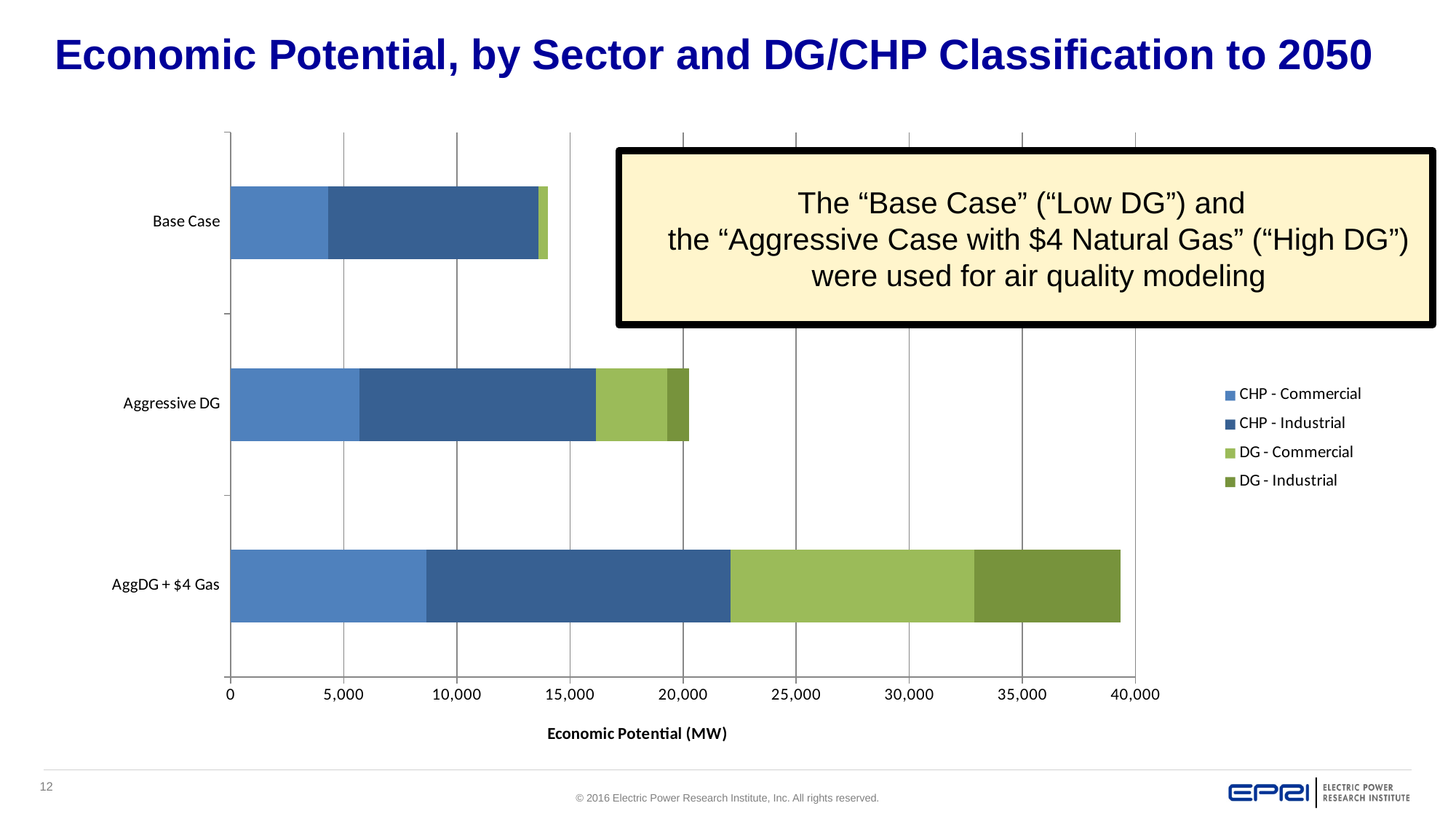
Which legend entry is shown in the darkest green colour? DG - Industrial Which scenario has the shortest total bar? Base Case Which scenario has the longest total bar? AggDG + $4 Gas Which has a larger total economic potential, Base Case or Aggressive DG? Aggressive DG What is the label of the horizontal axis? Economic Potential (MW) How many scenarios (categories) are plotted on the chart? 3 Is the total economic potential for the Base Case greater or less than 15,000 MW? less Is the total economic potential for the Base Case greater or less than 10,000 MW? greater How many series does the legend list? 4 In the AggDG + $4 Gas bar, which segment is larger, CHP - Commercial or CHP - Industrial? CHP - Industrial Is the total economic potential for AggDG + $4 Gas greater or less than 35,000 MW? greater What type of chart is shown on the slide? Stacked bar chart